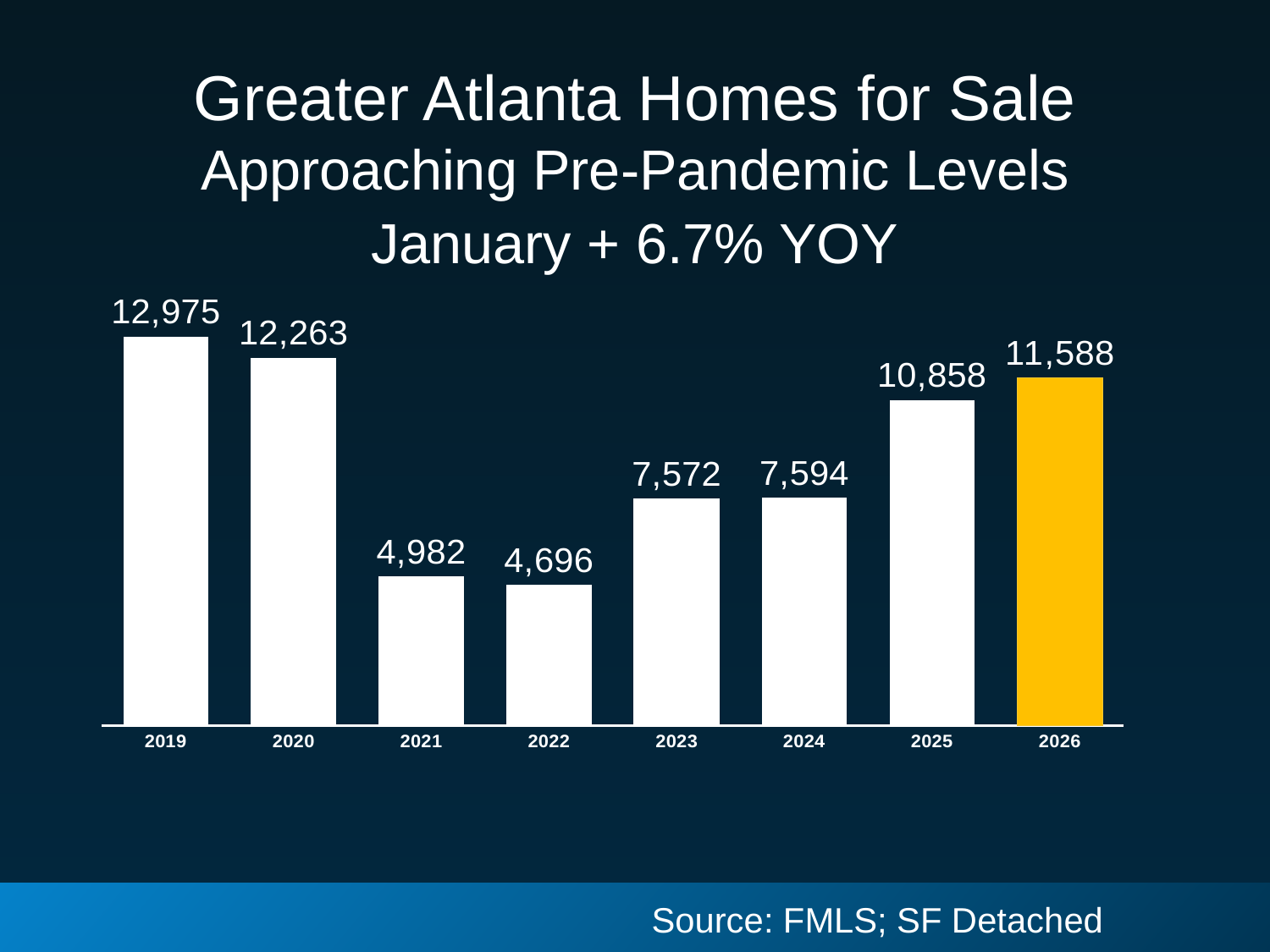
What is the difference between the values for 2026 and 2025? 730 What is the value for 2022? 4,696 Which year has the lowest value? 2022 Which is larger, the value for 2023 or the value for 2024? 2024 What kind of chart is this? bar chart Which year has the highest value? 2019 Which bar is coloured differently from the others? 2026 How many years are shown on the chart? 8 What is the value for 2019? 12,975 What is the difference between the values for 2019 and 2022? 8,279 What is the value for 2026? 11,588 Do the values rise or fall from 2022 to 2026? rise